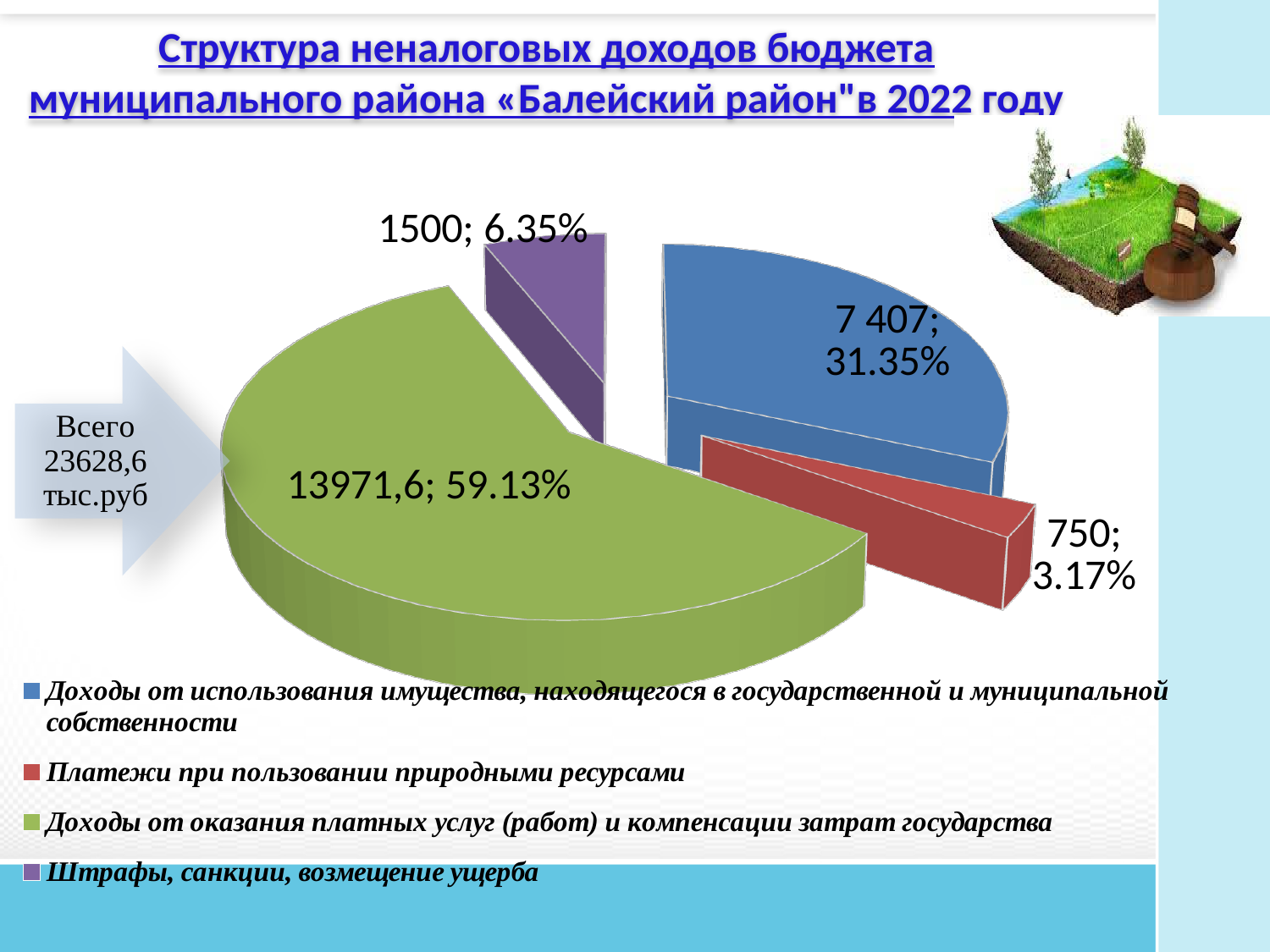
Какую долю круговой диаграммы занимает категория «Доходы от оказания платных услуг (работ) и компенсации затрат государства»? 59.13% Какое значение показано для категории «Доходы от использования имущества, находящегося в государственной и муниципальной собственности»? 7 407 Какое значение показано для категории «Доходы от оказания платных услуг (работ) и компенсации затрат государства»? 13971,6 Какая категория имеет наибольшее значение на диаграмме? Доходы от оказания платных услуг (работ) и компенсации затрат государства Какой тип диаграммы показан на слайде? Круговая диаграмма Какую долю круговой диаграммы занимает категория «Штрафы, санкции, возмещение ущерба»? 6.35% Что больше: значение для «Штрафы, санкции, возмещение ущерба» или для «Платежи при пользовании природными ресурсами»? Штрафы, санкции, возмещение ущерба Какая категория имеет наименьшее значение на диаграмме? Платежи при пользовании природными ресурсами Сколько категорий (секторов) показано на круговой диаграмме? 4 Какое значение показано для категории «Штрафы, санкции, возмещение ущерба»? 1500 Какое значение показано для категории «Платежи при пользовании природными ресурсами»? 750 Каким цветом на диаграмме показана категория «Платежи при пользовании природными ресурсами»? Красным